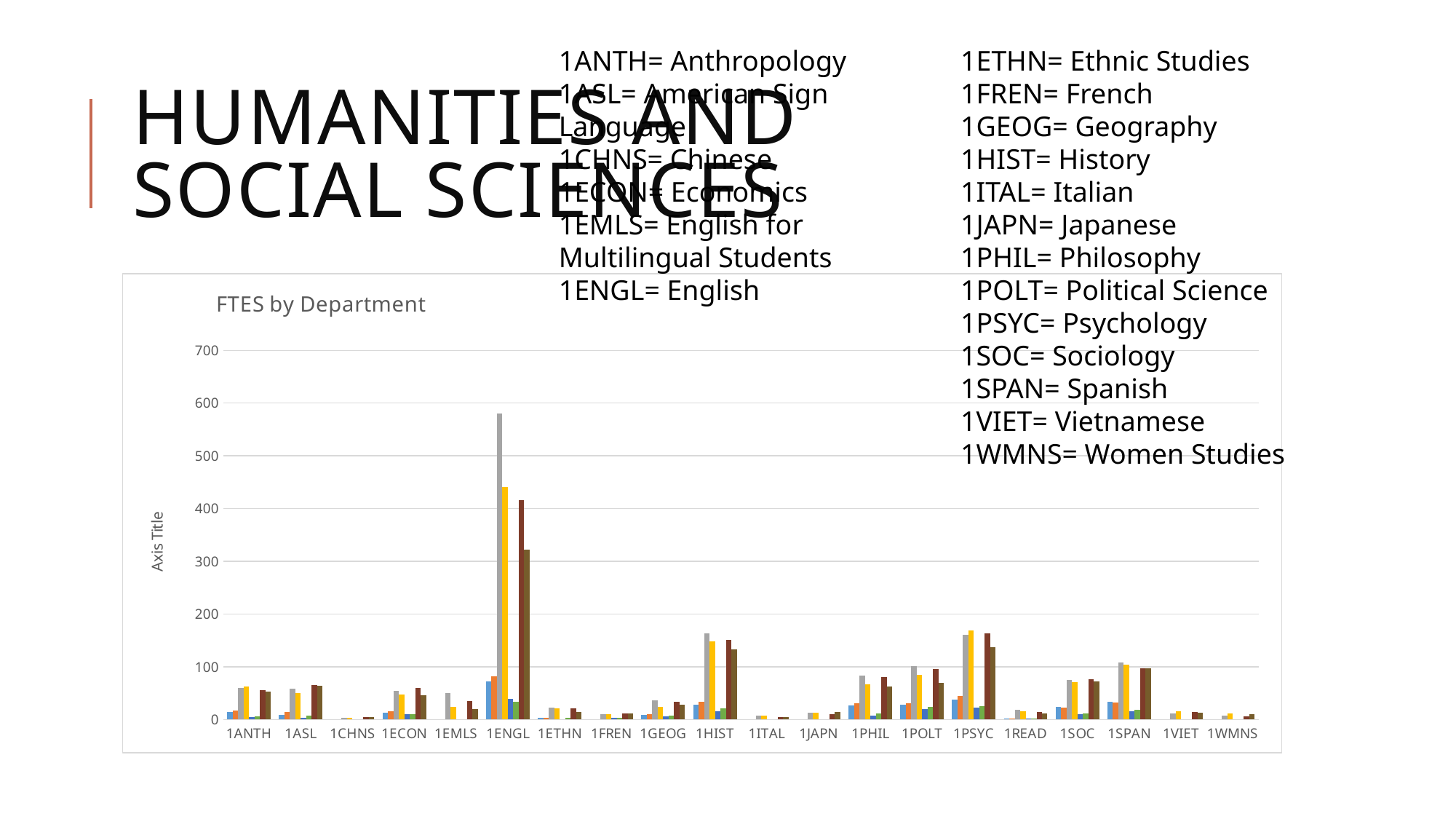
What kind of chart is shown on the slide? bar chart What is the title of the chart? FTES by Department How many departments (categories) are shown on the x axis of the chart? 20 Which department has the tallest bar in the chart? 1ENGL Is the tallest bar for 1ENGL greater or less than 500? greater Is the tallest bar for 1SPAN greater or less than 200? less Is the tallest bar for 1JAPN greater or less than 100? less Which department has higher bars overall, 1ENGL or 1HIST? 1ENGL Which department has higher bars overall, 1PSYC or 1JAPN? 1PSYC What is the highest value labelled on the vertical axis of the chart? 700